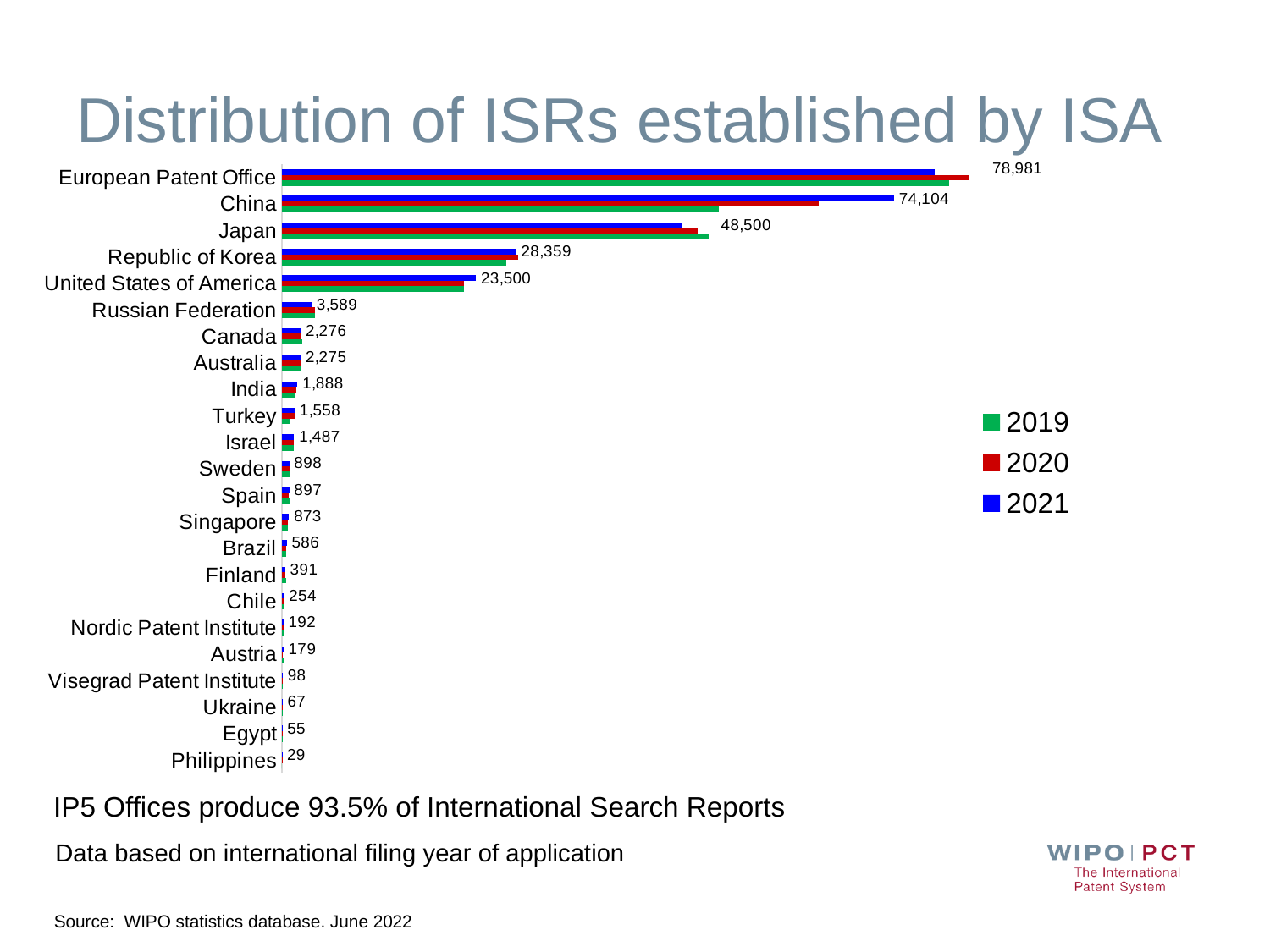
Which years are listed in the legend? 2019, 2020, 2021 Which ISA has the lowest labelled value? Philippines What colour represents the 2021 series? blue Which ISA has the highest labelled value? European Patent Office What value is labelled for the European Patent Office? 78,981 What is the difference between the labelled values for Canada and Australia? 1 Which has the larger labelled value, China or Japan? China What kind of chart is shown on the slide? bar chart How many series does the legend list? 3 How many ISAs (categories) are shown on the chart? 23 What value is labelled for the Philippines? 29 What value is labelled for Republic of Korea? 28,359